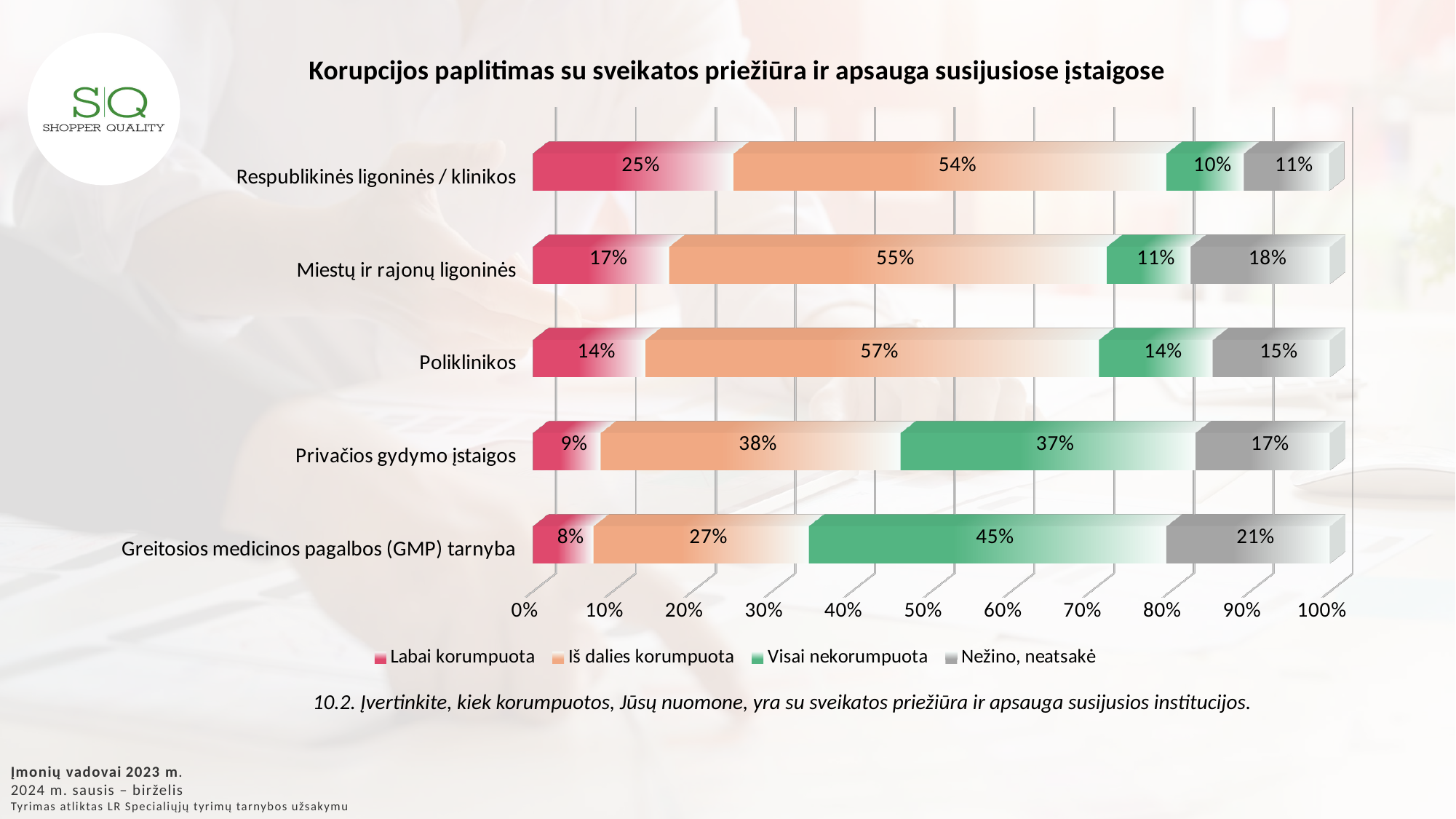
How many series does the legend list? 4 Which is larger: the 'Visai nekorumpuota' value for Privačios gydymo įstaigos or for Poliklinikos? Privačios gydymo įstaigos Which category has the highest 'Labai korumpuota' value? Respublikinės ligoninės / klinikos How many categories (institution types) are shown in the chart? 5 What is the 'Visai nekorumpuota' value for Greitosios medicinos pagalbos (GMP) tarnyba? 45% What is the total of the stacked bar for Poliklinikos? 100% What is the difference between the 'Iš dalies korumpuota' values for Poliklinikos and Privačios gydymo įstaigos? 19% What percentage of respondents rated Respublikinės ligoninės / klinikos as 'Labai korumpuota'? 25% What is the title of the chart? Korupcijos paplitimas su sveikatos priežiūra ir apsauga susijusiose įstaigose Which category has the lowest 'Iš dalies korumpuota' value? Greitosios medicinos pagalbos (GMP) tarnyba What kind of chart is shown on the slide? Stacked bar chart What is the 'Nežino, neatsakė' value for Miestų ir rajonų ligoninės? 18%